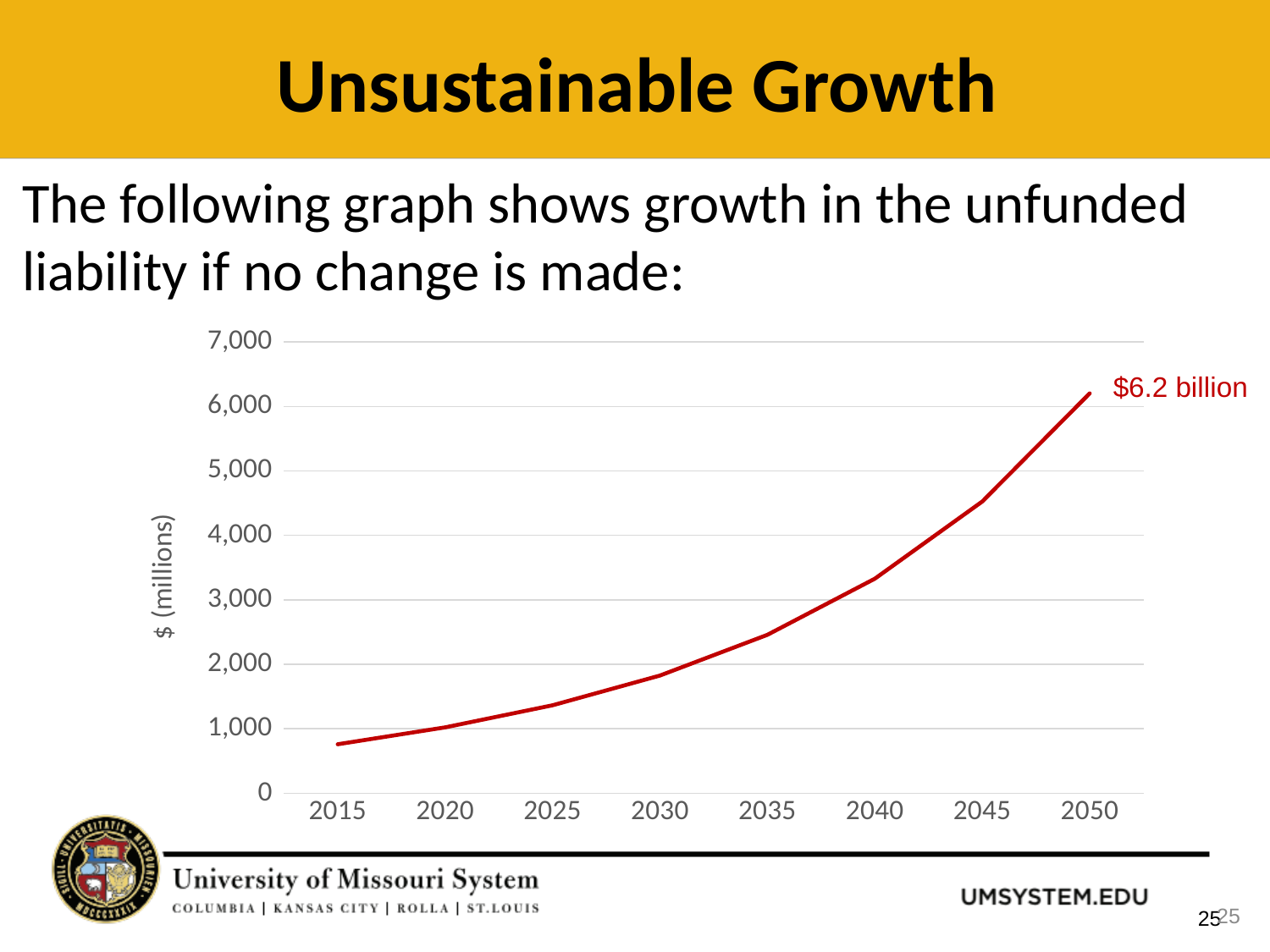
Which year has the highest unfunded liability on the chart? 2050 What value is labelled at the end of the line in 2050? $6.2 billion Which year has the lowest unfunded liability on the chart? 2015 Do the values rise or fall from 2015 to 2050? rise Is the value for 2015 greater or less than 1,000? less How many year labels are shown on the x axis? 8 Is the value for 2040 greater or less than 3,000? greater Which is larger, the value for 2035 or the value for 2025? 2035 Is the value for 2030 greater or less than 2,000? less What kind of chart is shown on the slide? line chart What is the label on the y axis? $ (millions)